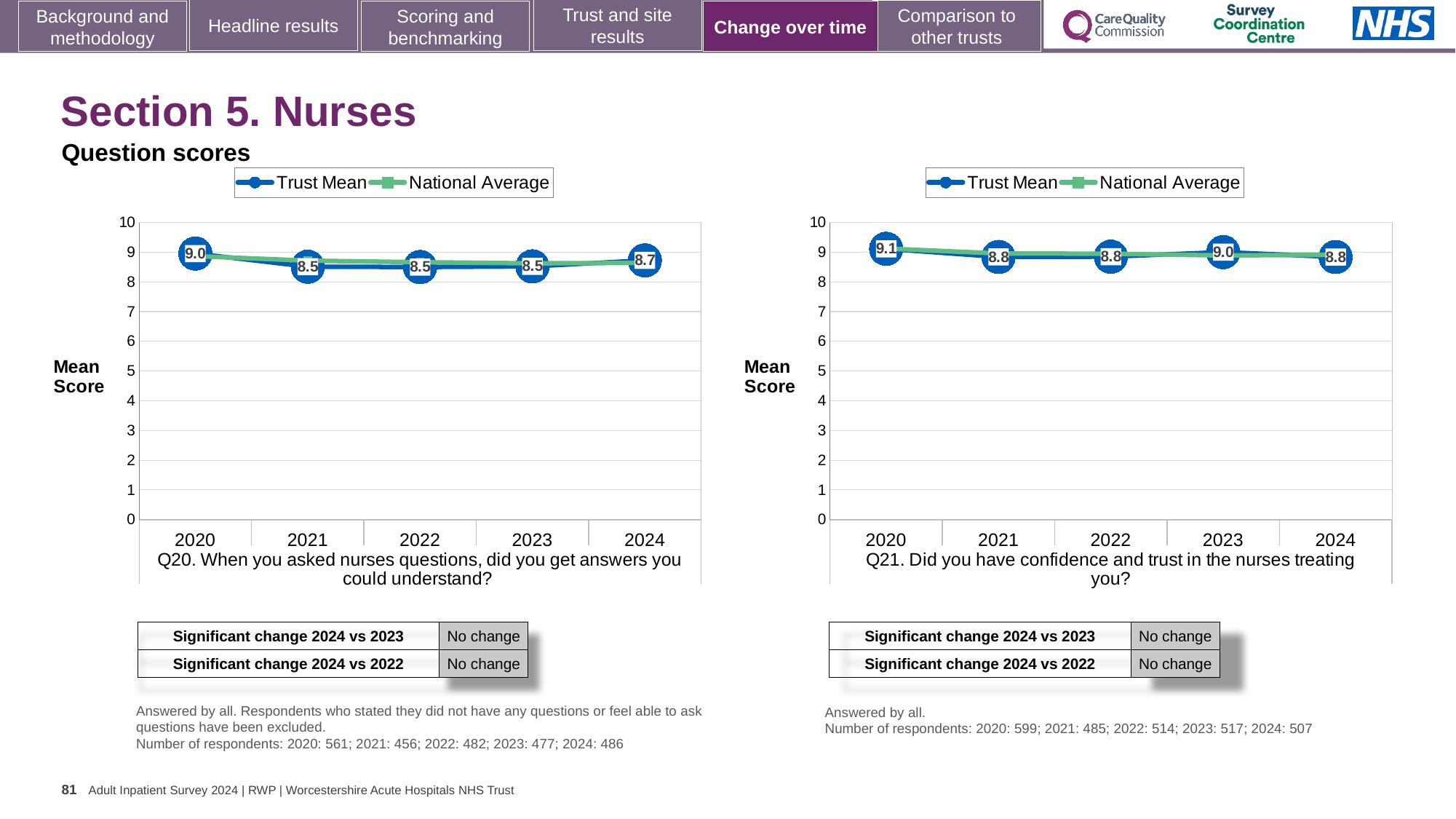
On the right chart (Q21), what is the Trust Mean score for 2020? 9.1 On the right chart (Q21), which is larger, the Trust Mean for 2023 or for 2024? 2023 On the right chart (Q21), how many years are plotted on the x axis? 5 On the left chart (Q20), what is the difference between the Trust Mean scores for 2020 and 2024? 0.3 On the left chart (Q20), how many series does the legend list? 2 On the right chart (Q21), what is the Trust Mean score for 2023? 9.0 On the left chart (Q20), which year has the highest Trust Mean score? 2020 On the left chart (Q20), did the Trust Mean rise or fall from 2020 to 2021? fall On the left chart (Q20), what is the Trust Mean score for 2024? 8.7 What kind of chart is the right chart (Q21)? line chart On the left chart (Q20), what is the Trust Mean score for 2020? 9.0 On the right chart (Q21), which year has the highest Trust Mean score? 2020